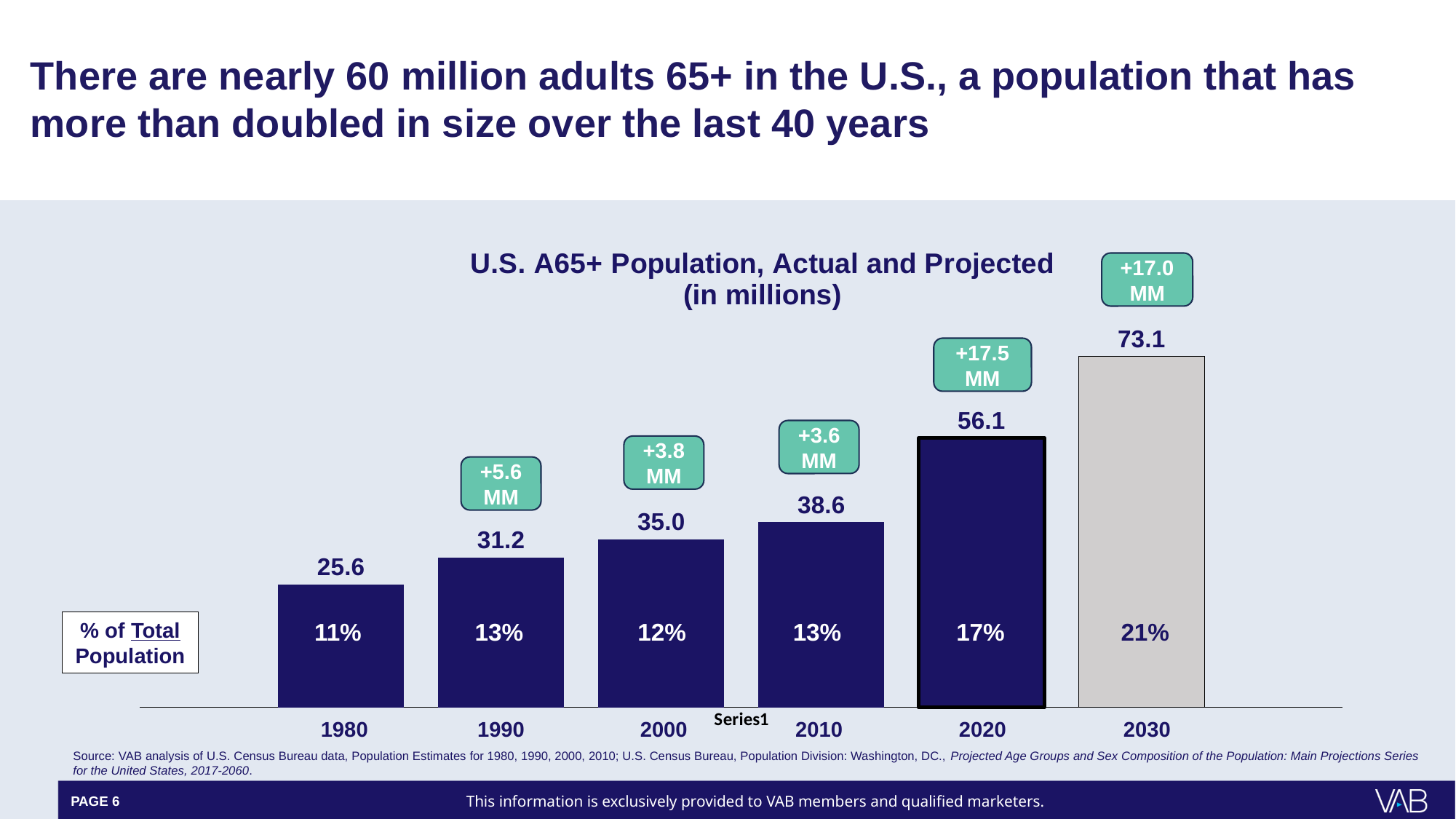
What is the title of the chart? U.S. A65+ Population, Actual and Projected (in millions) How many years (bars) are shown on the chart? 6 What percentage of the total population does the 2020 bar show? 17% Do the A65+ population values rise or fall from 1980 to 2030? Rise What increase in millions is labelled between 1990 and 2000? +3.8 MM Which year has the lowest A65+ population value on the chart? 1980 What kind of chart is shown on the slide? Bar chart What is the U.S. A65+ population value shown for 1980? 25.6 What is the projected A65+ population value shown for 2030? 73.1 What is the difference between the 2020 value (56.1) and the 2010 value (38.6)? 17.5 Which year has the highest A65+ population value on the chart? 2030 Which is larger, the value for 2000 or the value for 1990? 2000